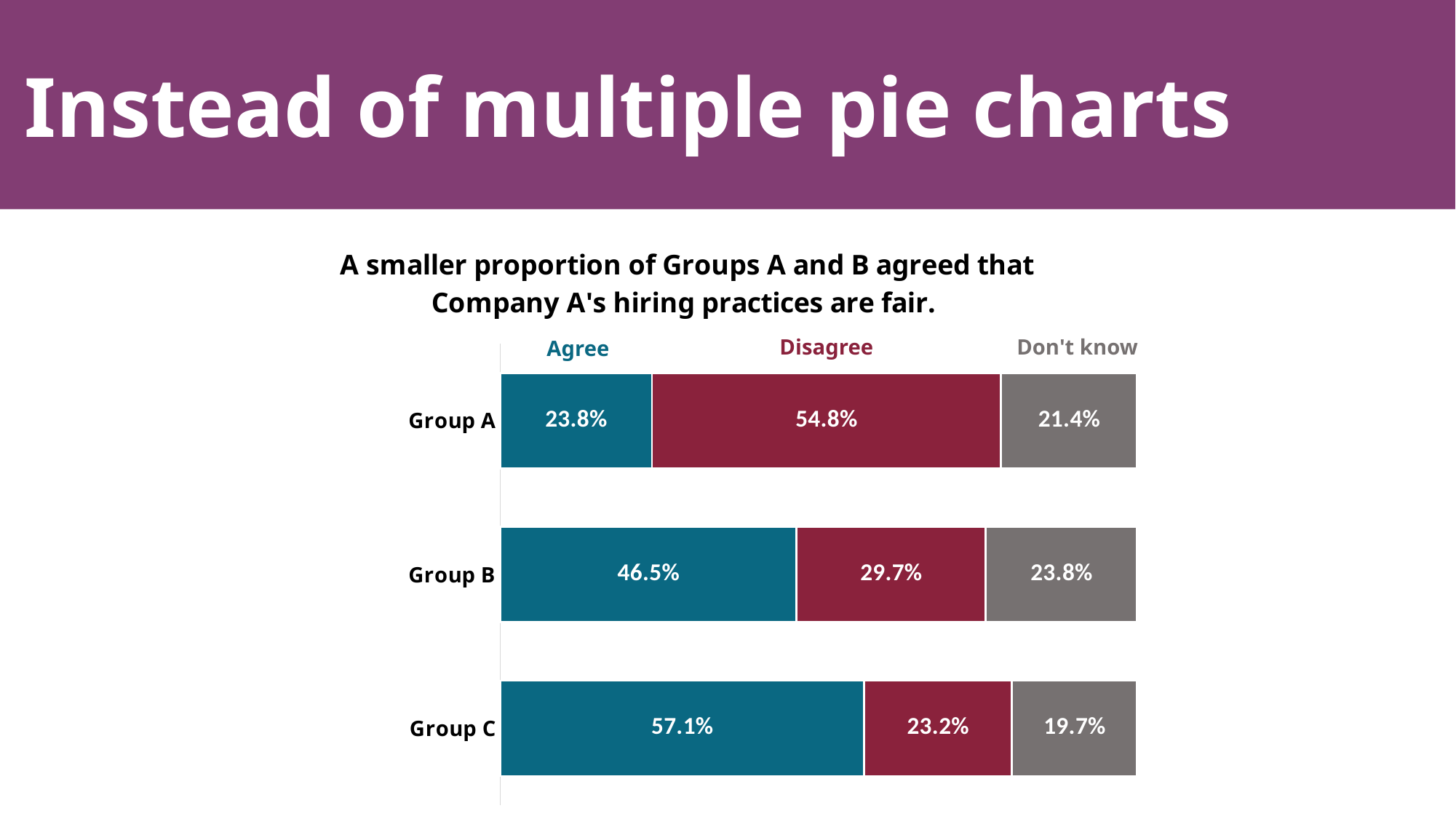
What is the 'Don't know' value for Group C? 19.7% What percentage of Group A agreed? 23.8% How many response categories (series) does the chart show? 3 Which is larger: Group B's Agree value or Group B's Disagree value? Group B's Agree value What is the total of the Group A bar? 100% What colour represents the Disagree category? Dark red What is the difference between the Agree percentages of Group C and Group A? 33.3% Which group has the lowest Disagree percentage? Group C Which group has the highest Agree percentage? Group C What percentage of Group B disagreed? 29.7% What type of chart is shown on the slide? Stacked bar chart How many groups are shown in the chart? 3